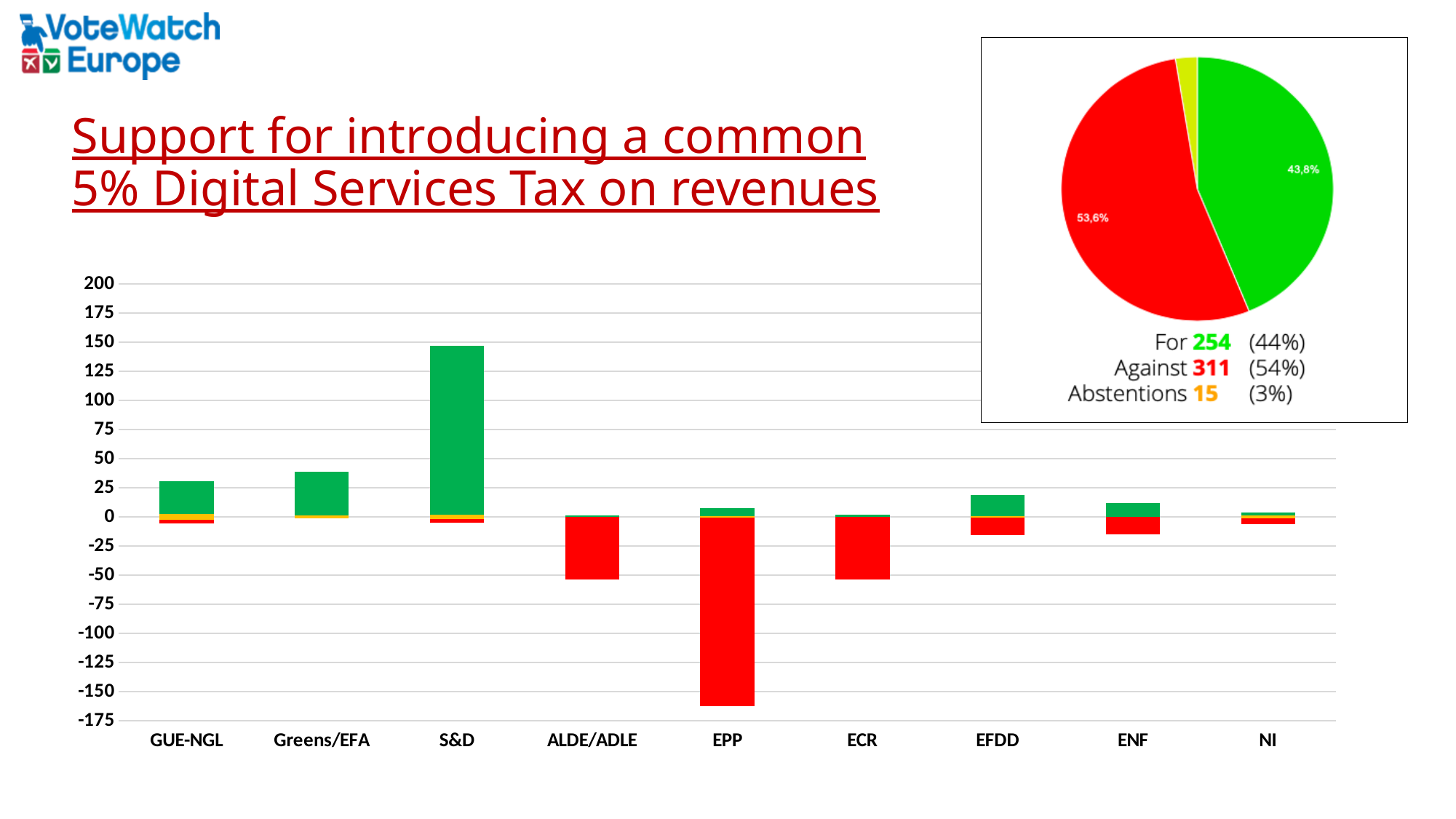
In the bar chart of political groups, which group has the tallest green (positive) bar? S&D In the bar chart of political groups, which group has the longest red (negative) bar? EPP In the pie chart at the top right, what is the difference between the Against votes and the For votes? 57 In the pie chart at the top right, what share is labelled on the green slice? 43,8% In the pie chart at the top right, how many Abstentions are listed? 15 In the pie chart at the top right, what share is labelled on the red slice? 53,6% In the bar chart of political groups, is the green bar for S&D greater or less than 125? greater In the bar chart of political groups, is the green bar for Greens/EFA greater or less than 25? greater In the pie chart at the top right, how many votes were Against? 311 In the bar chart of political groups, is the red bar for EPP greater or less than -150? less In the bar chart of political groups, how many groups are shown on the x axis? 9 What kind of chart is the chart at the bottom left of the slide, showing political groups? bar chart